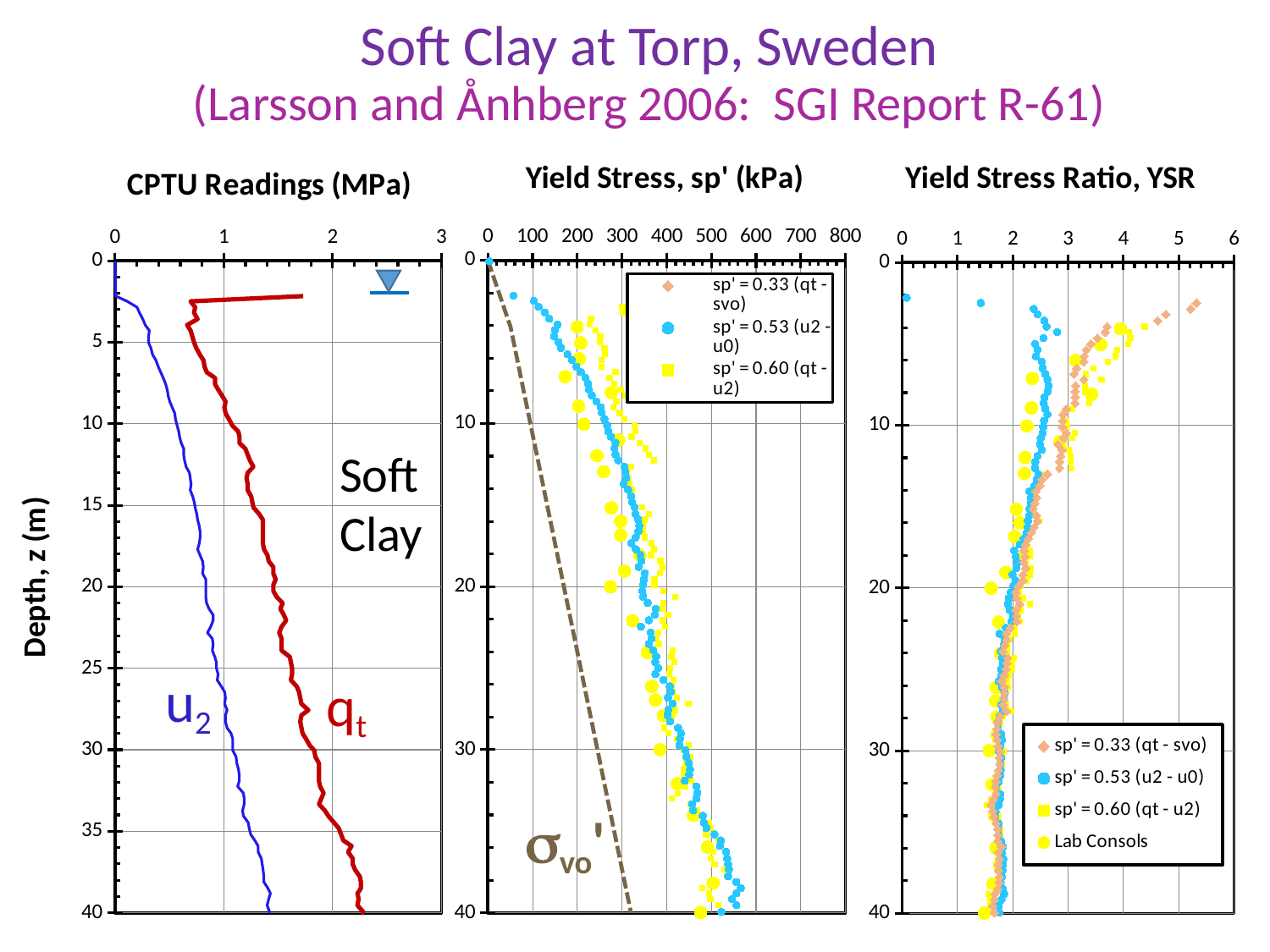
In the Yield Stress Ratio, YSR chart, is the sp' = 0.53 (u2 - u0) value at a depth of 40 m greater or less than 2? less What kind of chart is the Yield Stress, sp' (kPa) chart in the middle? scatter chart What kind of chart is the CPTU Readings (MPa) chart on the left? line chart How many series does the legend of the Yield Stress, sp' (kPa) chart list? 3 In the CPTU Readings (MPa) chart, is the value of qt at a depth of 40 m greater or less than 2? greater How many series does the legend of the Yield Stress Ratio, YSR chart list? 4 In the CPTU Readings (MPa) chart, at a depth of 30 m, which is larger, qt or u2? qt In the CPTU Readings (MPa) chart, is the value of u2 at a depth of 20 m greater or less than 1? less In the CPTU Readings (MPa) chart, does qt increase or decrease as depth increases from 5 m to 40 m? increase In the Yield Stress, sp' (kPa) chart, what does the dashed line represent? σvo' What is the maximum value shown on the x axis of the Yield Stress Ratio, YSR chart? 6